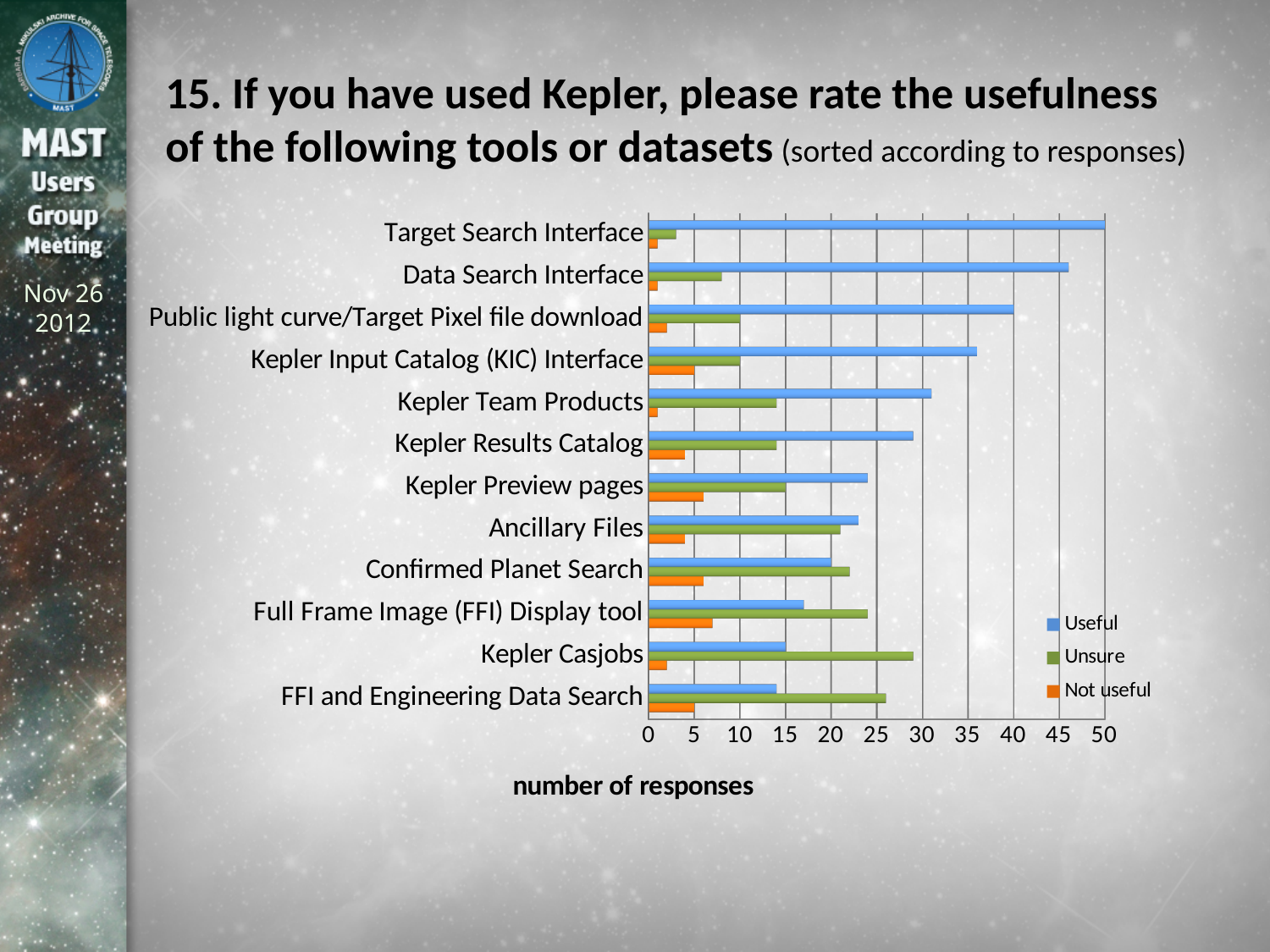
Which tool or dataset has the highest number of 'Useful' responses? Target Search Interface Which tool or dataset has the lowest number of 'Useful' responses? FFI and Engineering Data Search How many 'Useful' responses did Target Search Interface receive? 50 Is the number of 'Not useful' responses for Kepler Team Products greater or less than 5? less Is the number of 'Useful' responses for Data Search Interface greater or less than 40? greater Which tool or dataset has the highest number of 'Unsure' responses? Kepler Casjobs What type of chart is shown on the slide? bar chart Is the number of 'Unsure' responses for Kepler Casjobs greater or less than 25? greater How many tools or datasets are listed on the chart? 12 What is the title of the horizontal axis? number of responses How many series does the legend list? 3 Which has more 'Useful' responses: Kepler Preview pages or Kepler Casjobs? Kepler Preview pages